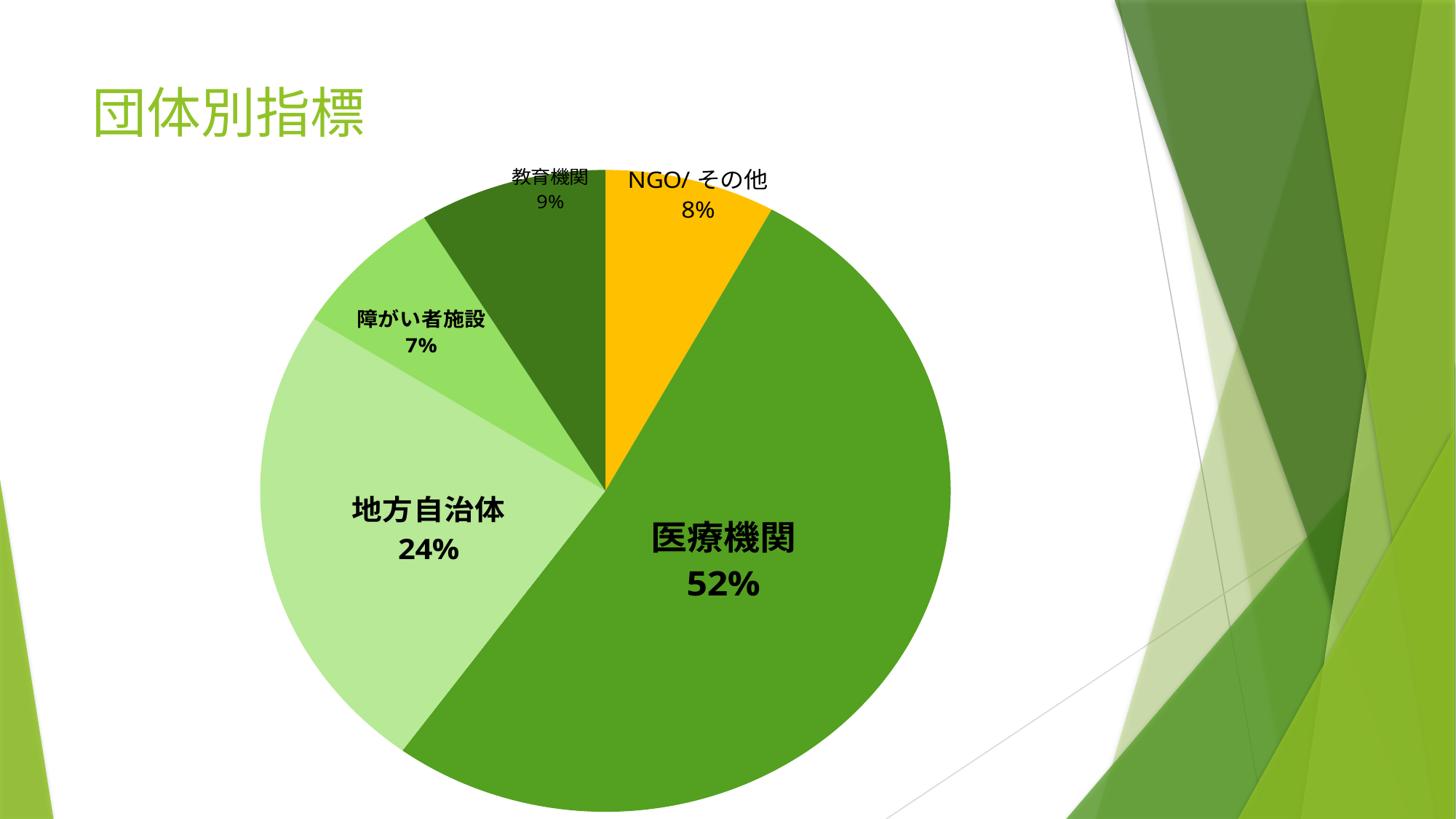
What is the difference between the shares of 医療機関 and 地方自治体? 28% What is the value shown for 障がい者施設? 7% What is the title of the slide containing the chart? 団体別指標 What share of the pie does 地方自治体 hold? 24% Which category has the smallest slice of the pie? 障がい者施設 What is the value shown for NGO/ その他? 8% What share of the pie does 医療機関 hold? 52% Which is larger, the share for 教育機関 or the share for NGO/ その他? 教育機関 Which category has the largest slice of the pie? 医療機関 What is the value shown for 教育機関? 9% What kind of chart is shown on the slide? Pie chart How many categories are shown in the pie chart? 5